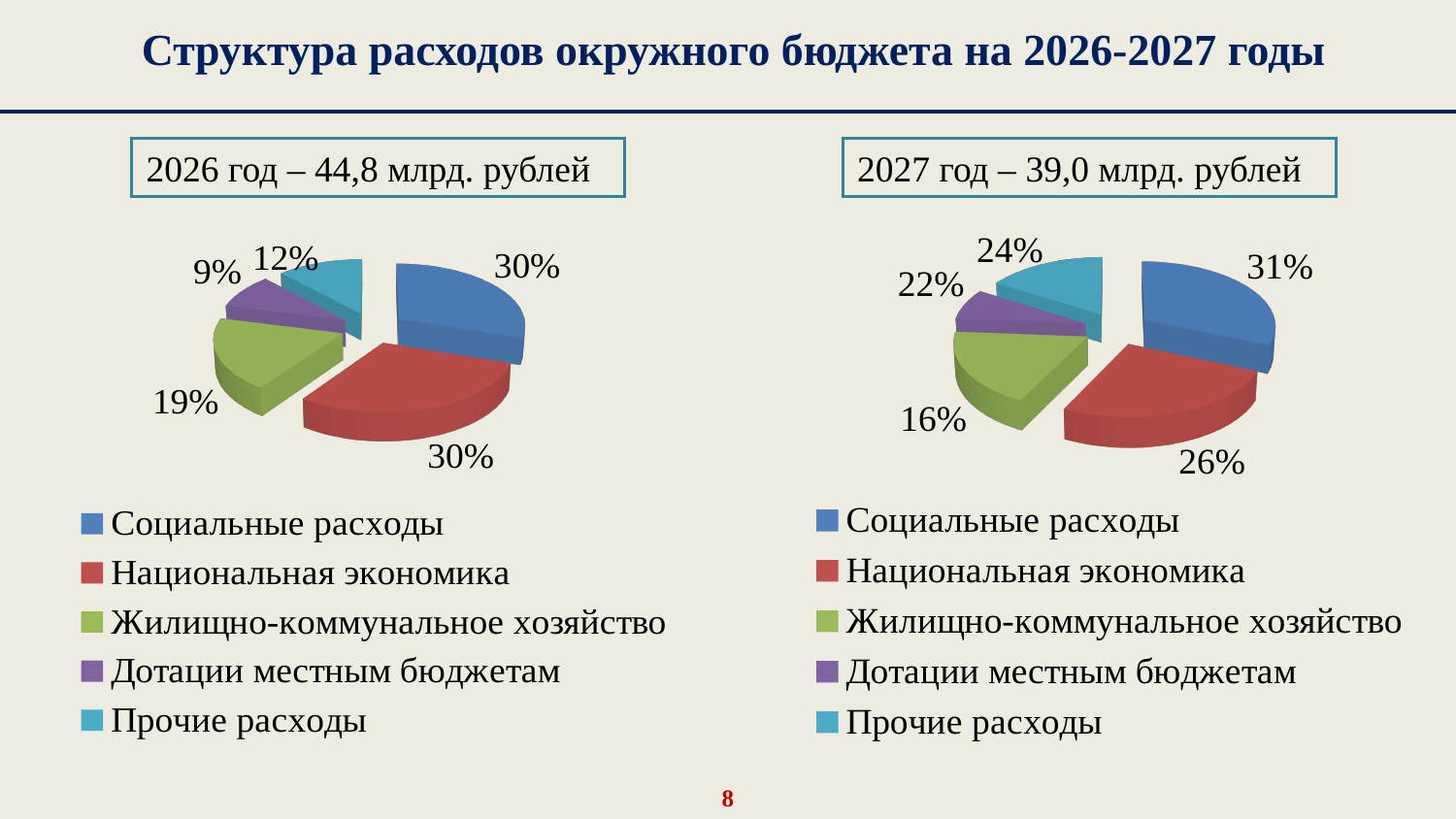
In the 2027 pie chart, which is larger: Социальные расходы or Жилищно-коммунальное хозяйство? Социальные расходы How many categories does the legend of the 2026 chart list? 5 In the 2026 pie chart, what share is Социальные расходы? 30% In the 2026 pie chart, which category has the smallest share? Дотации местным бюджетам In the 2027 pie chart, what share is Национальная экономика? 26% In the 2027 pie chart, what share is Социальные расходы? 31% In the 2026 pie chart, what share is Жилищно-коммунальное хозяйство? 19% In the 2027 pie chart, what share is Жилищно-коммунальное хозяйство? 16% In the 2027 pie chart, which category has the largest share? Социальные расходы In the 2026 pie chart, what share is Прочие расходы? 12% In the 2026 pie chart, how many percentage points larger is Социальные расходы than Дотации местным бюджетам? 21 percentage points What kind of chart is used for the 2027 budget structure? Pie chart